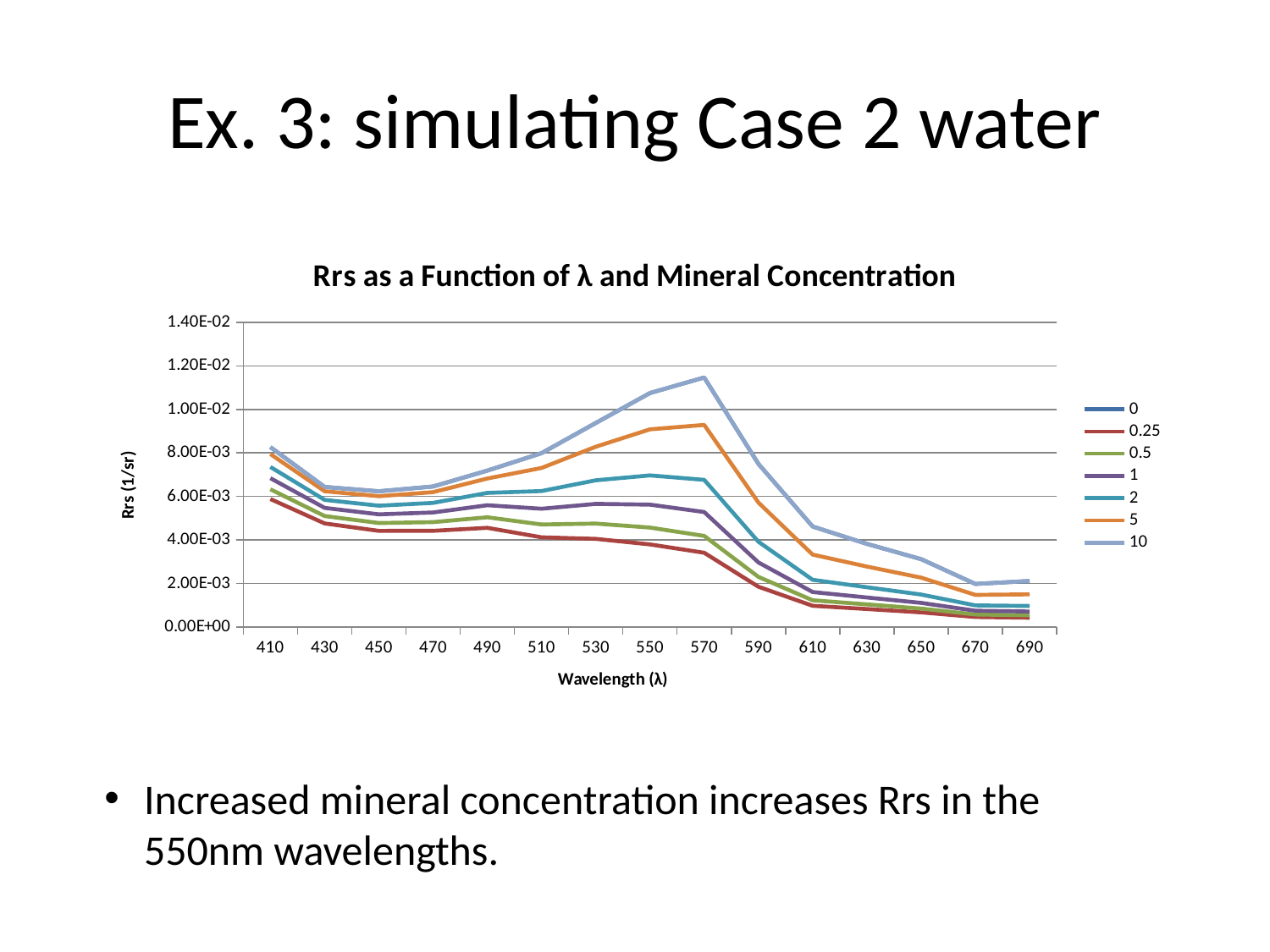
Is the value for series 5 at wavelength 670 greater or less than 2.00E-03? less What is the title of the chart? Rrs as a Function of λ and Mineral Concentration What is the label of the y axis? Rrs (1/sr) Is the value for series 5 at wavelength 570 greater or less than 8.00E-03? greater What kind of chart is shown on the slide? line chart How many wavelength points are plotted along the x axis? 15 How many series does the legend list? 7 For series 10, is the value at wavelength 570 larger or the value at wavelength 410? 570 Do the values for series 10 rise or fall from wavelength 570 to 670? fall At which wavelength does the series 10 reach its highest value? 570 Is the value for series 10 at wavelength 570 greater or less than 1.00E-02? greater